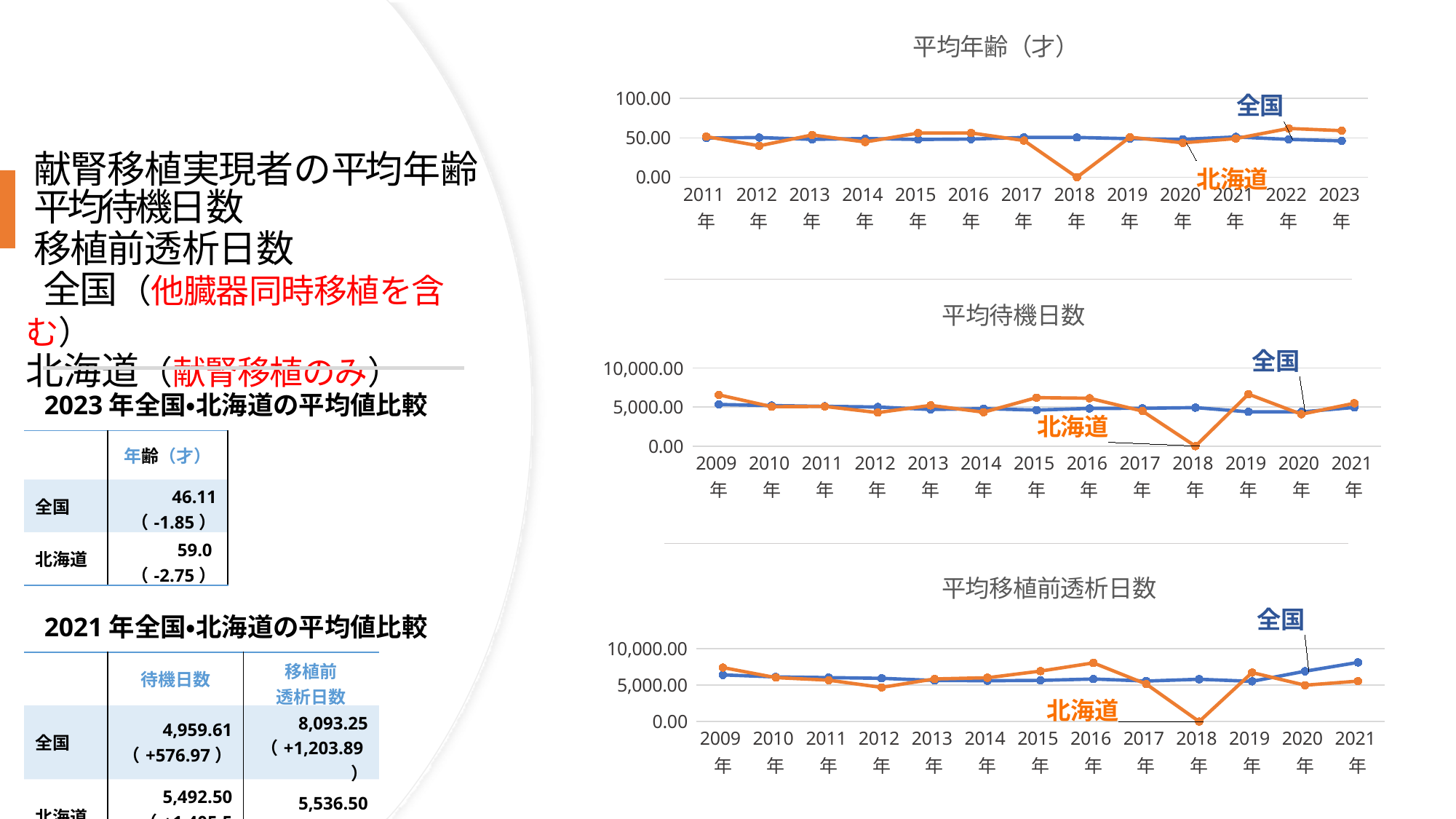
In the 平均年齢（才） chart, is the value for 北海道 in 2018年 greater or less than 50.00? less In the 平均待機日数 chart, is the value for 北海道 in 2009年 greater or less than 5,000.00? greater In the 平均待機日数 chart, which year has the lowest value for 北海道? 2018年 What kind of chart is the 平均年齢（才） chart at the top right? line chart In the 平均移植前透析日数 chart, is the value for 北海道 in 2018年 greater or less than 5,000.00? less In the 平均移植前透析日数 chart, which series has the higher value in 2021年, 全国 or 北海道? 全国 How many years are shown on the x axis of the 平均待機日数 chart? 13 How many years are shown on the x axis of the 平均年齢（才） chart? 13 How many series does the 平均年齢（才） chart plot? 2 In the 平均移植前透析日数 chart, which colour is used for the 北海道 line? orange In the 平均年齢（才） chart, which year has the lowest value for 北海道? 2018年